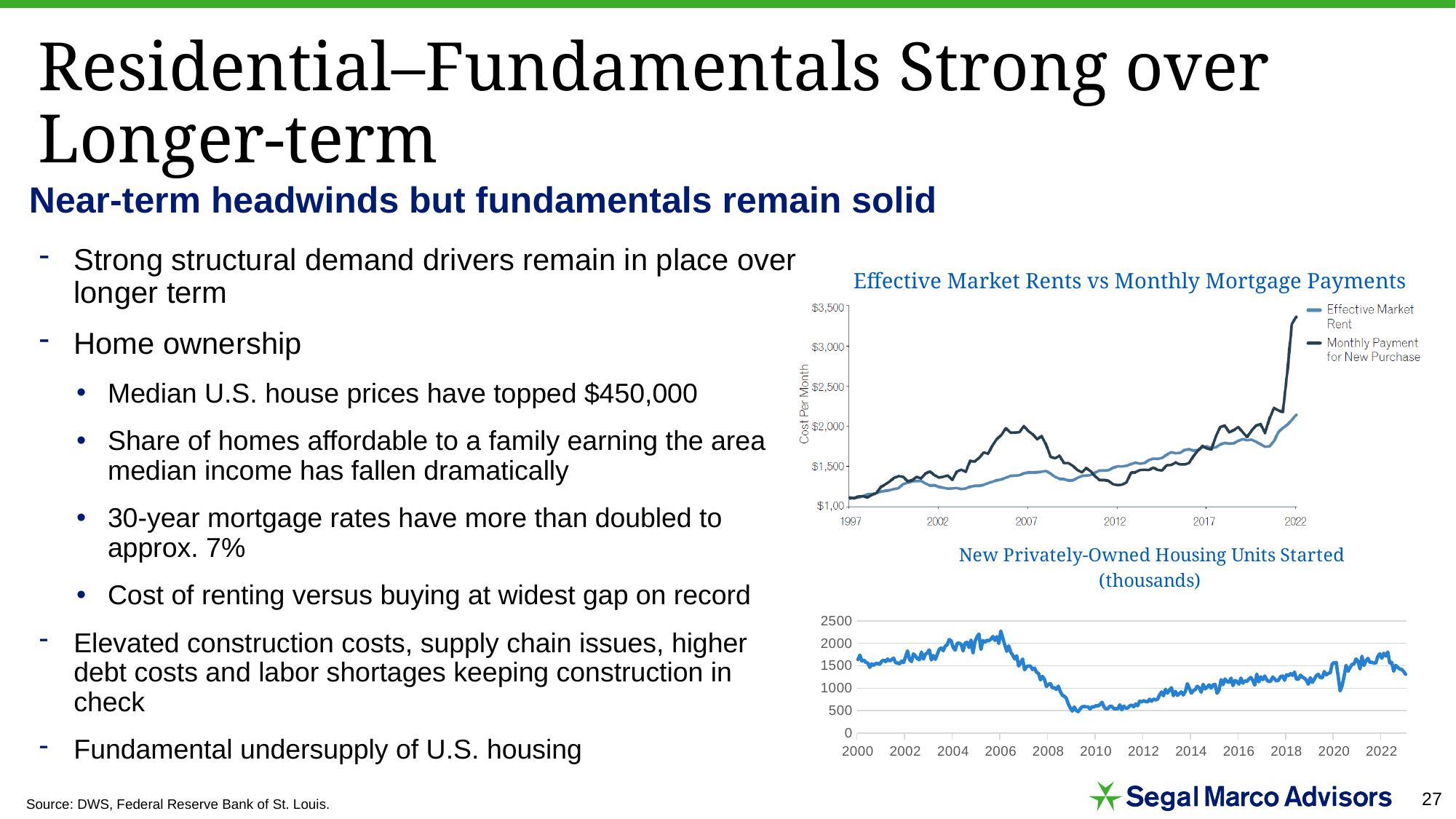
In the 'Effective Market Rents vs Monthly Mortgage Payments' chart, which series is higher around 2007: Effective Market Rent or Monthly Payment for New Purchase? Monthly Payment for New Purchase In the 'New Privately-Owned Housing Units Started (thousands)' chart, is the value around 2009 greater or less than 1000? less What is the y-axis label of the 'Effective Market Rents vs Monthly Mortgage Payments' chart? Cost Per Month How many series does the legend of the 'Effective Market Rents vs Monthly Mortgage Payments' chart list? 2 In the 'New Privately-Owned Housing Units Started (thousands)' chart, is the peak value around 2006 greater or less than 2000? greater In the 'Effective Market Rents vs Monthly Mortgage Payments' chart, is the Effective Market Rent at the end of 2022 greater or less than $2,500? less What kind of chart is the 'New Privately-Owned Housing Units Started (thousands)' chart? Line chart In the 'Effective Market Rents vs Monthly Mortgage Payments' chart, what are the two series named in the legend? Effective Market Rent; Monthly Payment for New Purchase In the 'New Privately-Owned Housing Units Started (thousands)' chart, do values rise or fall between 2006 and 2009? Fall What kind of chart is the 'Effective Market Rents vs Monthly Mortgage Payments' chart? Line chart In the 'Effective Market Rents vs Monthly Mortgage Payments' chart, which series is higher at the end of 2022? Monthly Payment for New Purchase